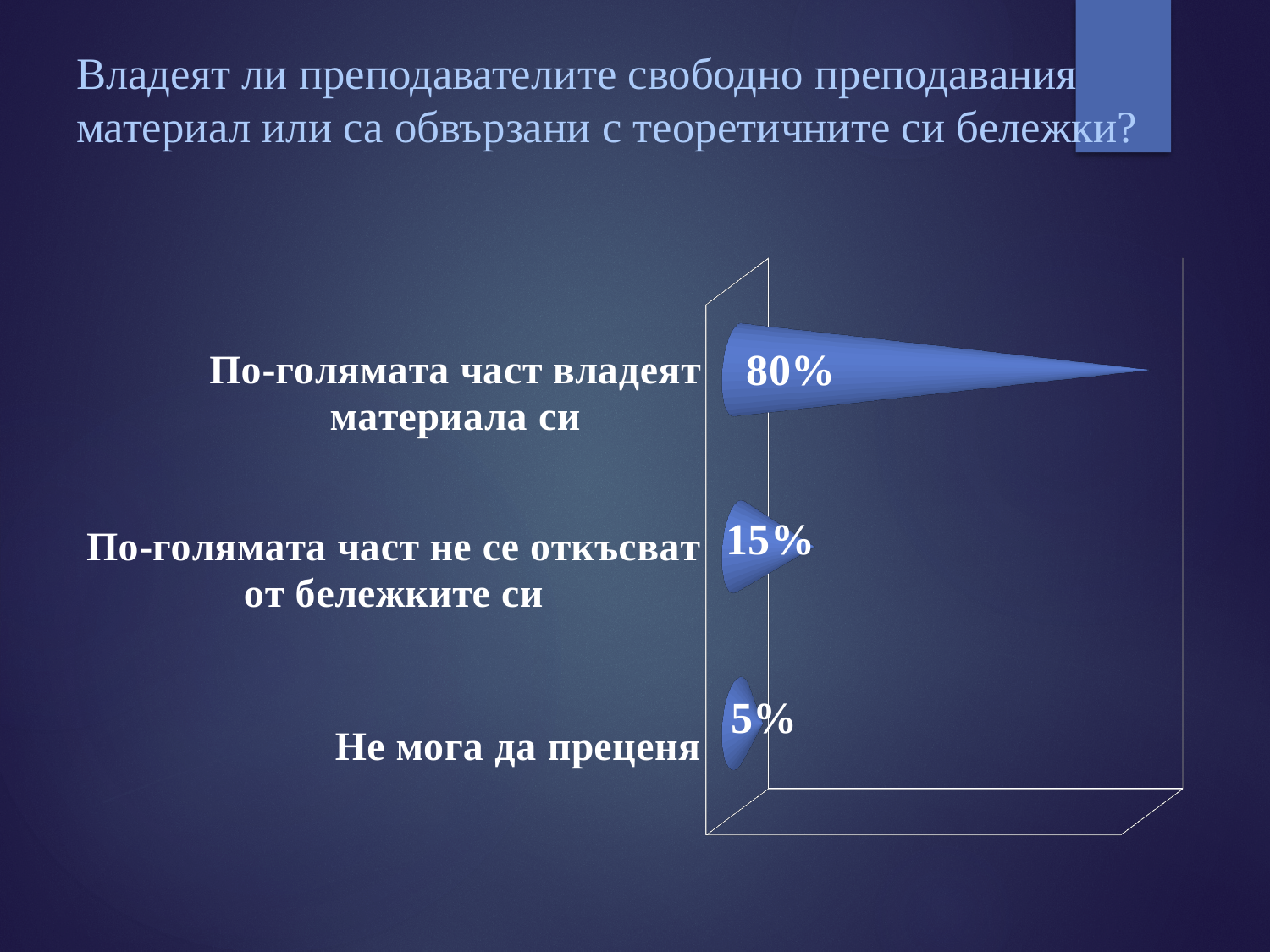
What is the value for "Не мога да преценя"? 5% What is the value for "По-голямата част владеят материала си"? 80% Which is larger: the value for "По-голямата част не се откъсват от бележките си" or for "Не мога да преценя"? По-голямата част не се откъсват от бележките си Which category has the lowest value? Не мога да преценя What kind of chart is shown on the slide? Bar chart What is the difference between the values for "По-голямата част владеят материала си" and "По-голямата част не се откъсват от бележките си"? 65% What is the total of the three values shown in the chart? 100% How many categories does the chart show? 3 Which category has the highest value? По-голямата част владеят материала си What is the difference between the values for "По-голямата част не се откъсват от бележките си" and "Не мога да преценя"? 10% Are the bars in the chart horizontal or vertical? Horizontal What is the value for "По-голямата част не се откъсват от бележките си"? 15%